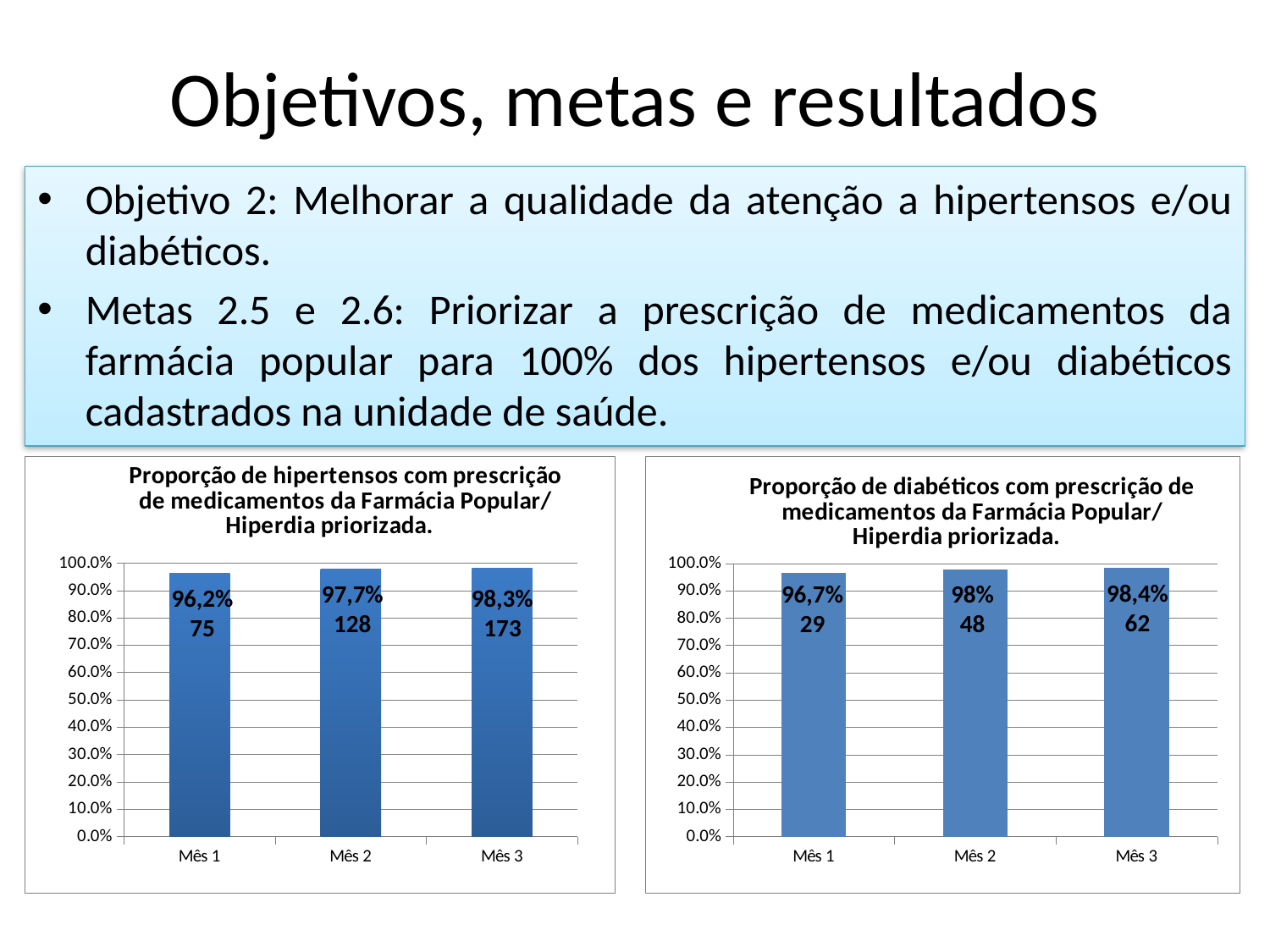
In the chart on the left (hipertensos), what number is printed on the bar for Mês 3? 173 In the chart on the left (hipertensos), what is the difference between the numbers printed for Mês 3 and Mês 2? 45 What type of chart is the chart on the left (hipertensos)? Bar chart In the chart on the right (diabéticos), what number is printed on the bar for Mês 1? 29 In the chart on the left (hipertensos), what percentage is shown for Mês 1? 96,2% In the chart on the left (hipertensos), which month has the highest percentage? Mês 3 In the chart on the right (diabéticos), do the percentages rise or fall from Mês 1 to Mês 3? Rise In the chart on the right (diabéticos), what is the difference between the numbers printed for Mês 3 and Mês 1? 33 How many months (categories) are shown in the chart on the right (diabéticos)? 3 In the chart on the right (diabéticos), what percentage is shown for Mês 2? 98% In the chart on the left (hipertensos), which is larger, the percentage for Mês 1 or for Mês 2? Mês 2 In the chart on the right (diabéticos), which month has the lowest percentage? Mês 1